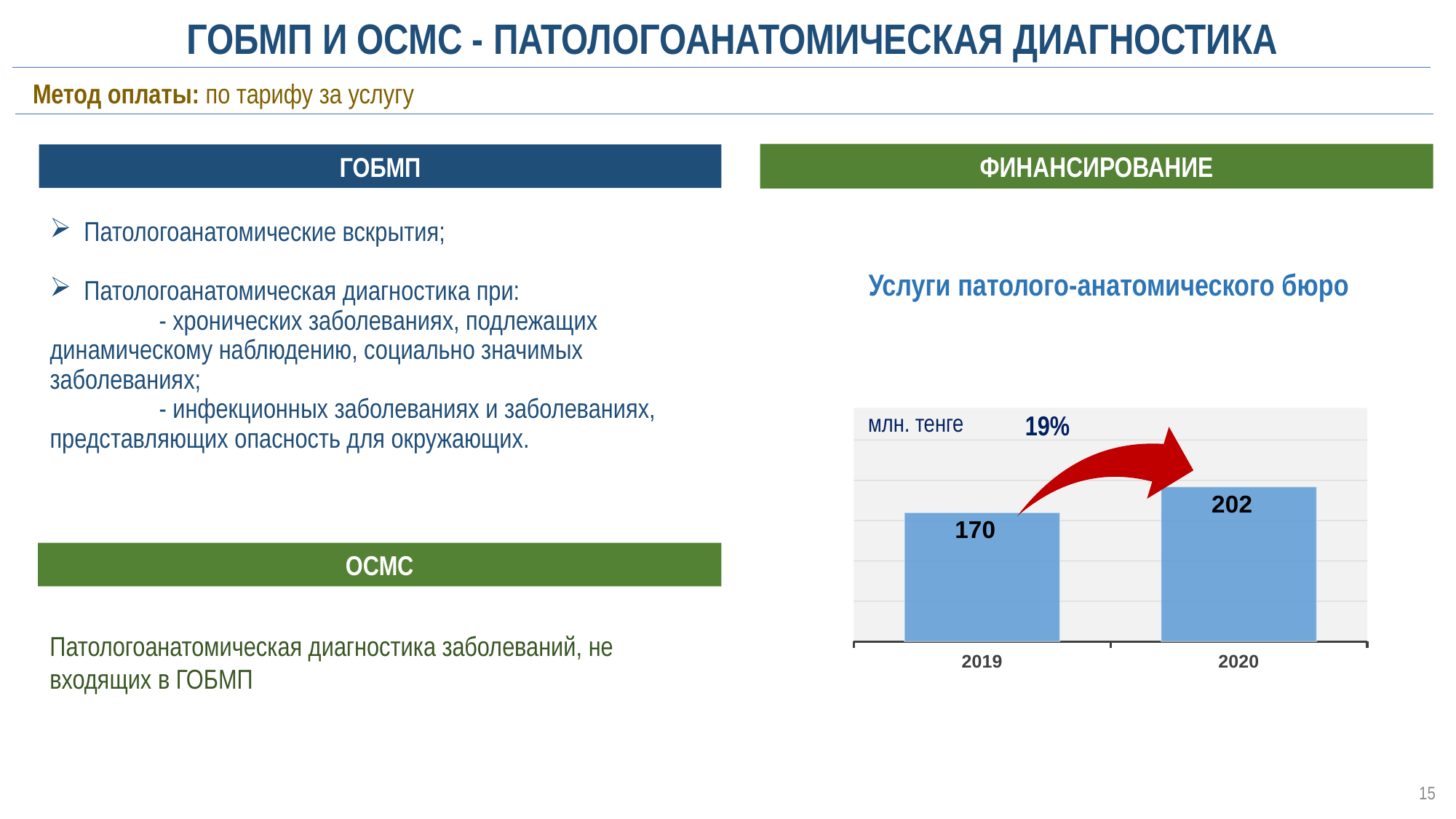
What is the title of the chart? Услуги патолого-анатомического бюро What percentage change is shown by the arrow on the chart? 19% How many categories (years) are shown in the chart? 2 Which year has the highest value in the chart? 2020 What is the value for 2020 in the chart? 202 What is the difference between the 2020 and 2019 values in the chart? 32 What is the value for 2019 in the chart? 170 Which is larger in the chart, the value for 2019 or the value for 2020? 2020 Which year has the lowest value in the chart? 2019 What kind of chart is shown on the slide? bar chart Do the values rise or fall from 2019 to 2020 in the chart? rise What unit is indicated on the chart? млн. тенге